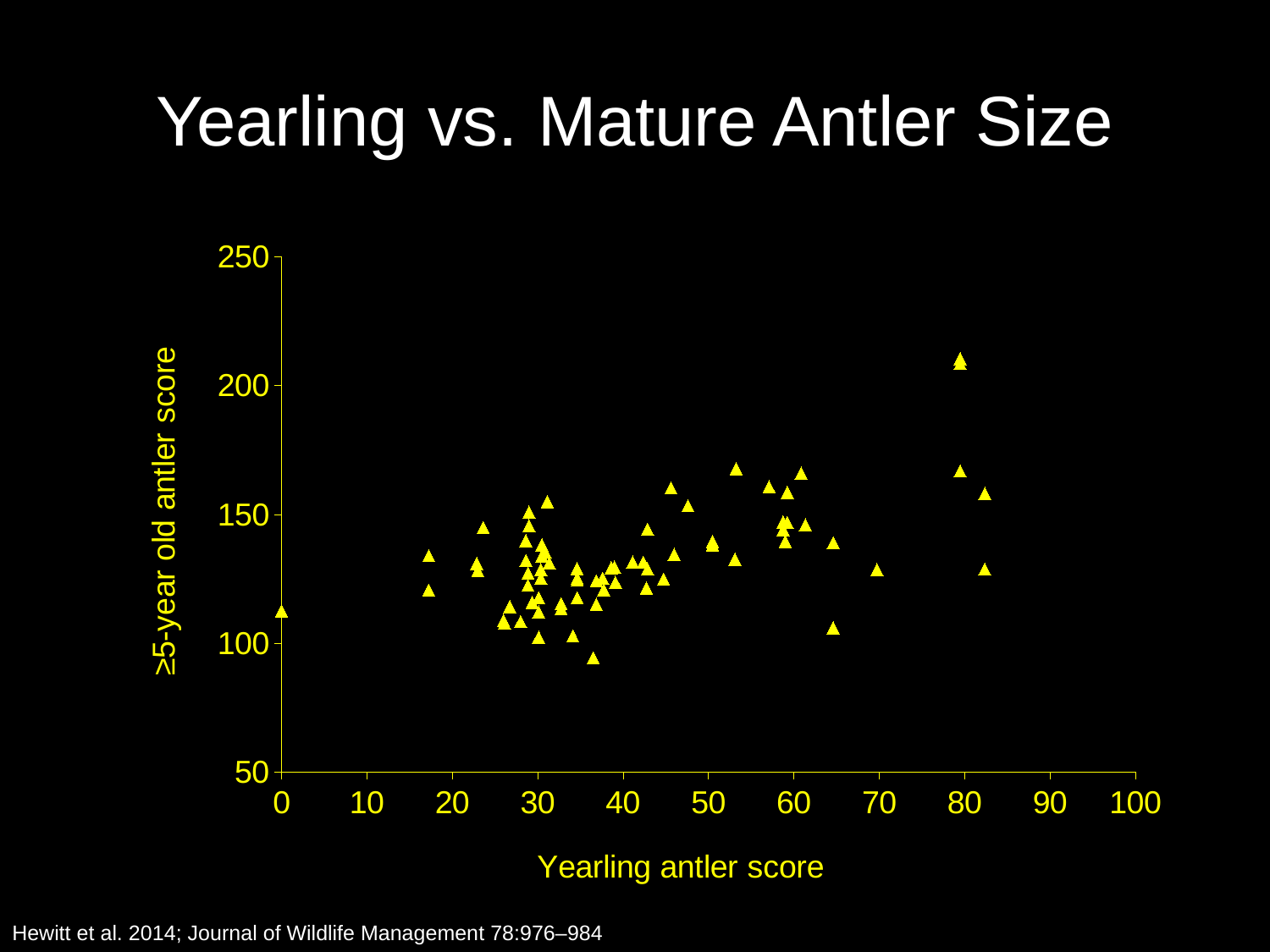
Is the ≥5-year old antler score of the point plotted at a yearling antler score of 0 greater or less than 150? less Is the highest ≥5-year old antler score plotted greater or less than 200? greater What kind of chart is shown on the slide? Scatter chart Is the ≥5-year old antler score of the point plotted at a yearling antler score of 0 greater or less than 100? greater What is the title of the chart? Yearling vs. Mature Antler Size Do the ≥5-year old antler scores generally rise or fall as the yearling antler score increases? Rise What is the label of the x axis? Yearling antler score